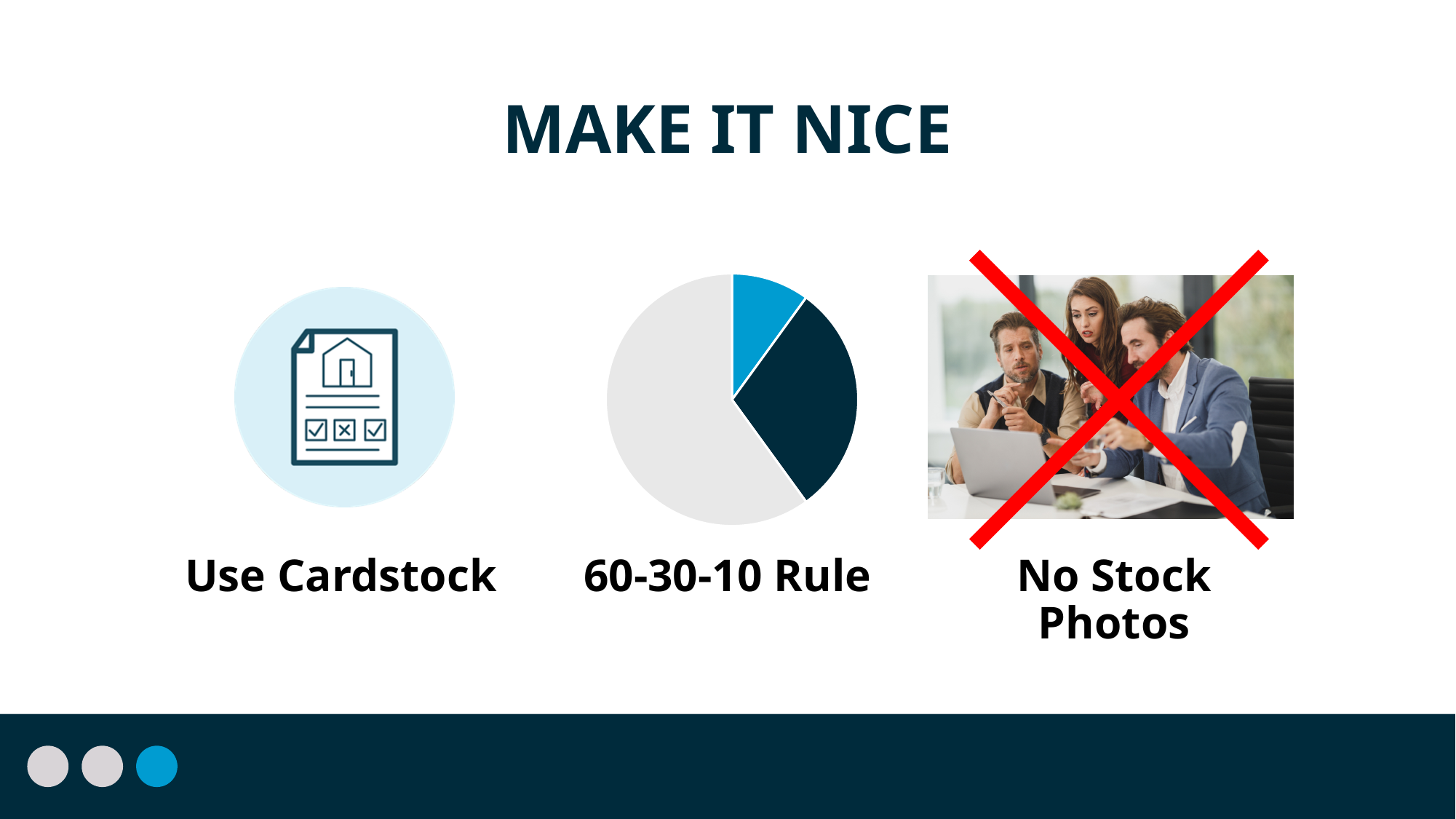
In the pie chart, which is larger, the dark navy slice or the light blue slice? the dark navy slice In the pie chart, which is larger, the light gray slice or the dark navy slice? the light gray slice Does the pie chart have a legend? No How many slices does the pie chart have? 3 Which slice of the pie chart is the smallest? the light blue slice Which slice of the pie chart is the largest? the light gray slice Does the light gray slice of the pie chart take up more or less than half of the pie? more What kind of chart is shown in the middle of the slide? pie chart What label appears directly below the pie chart? 60-30-10 Rule